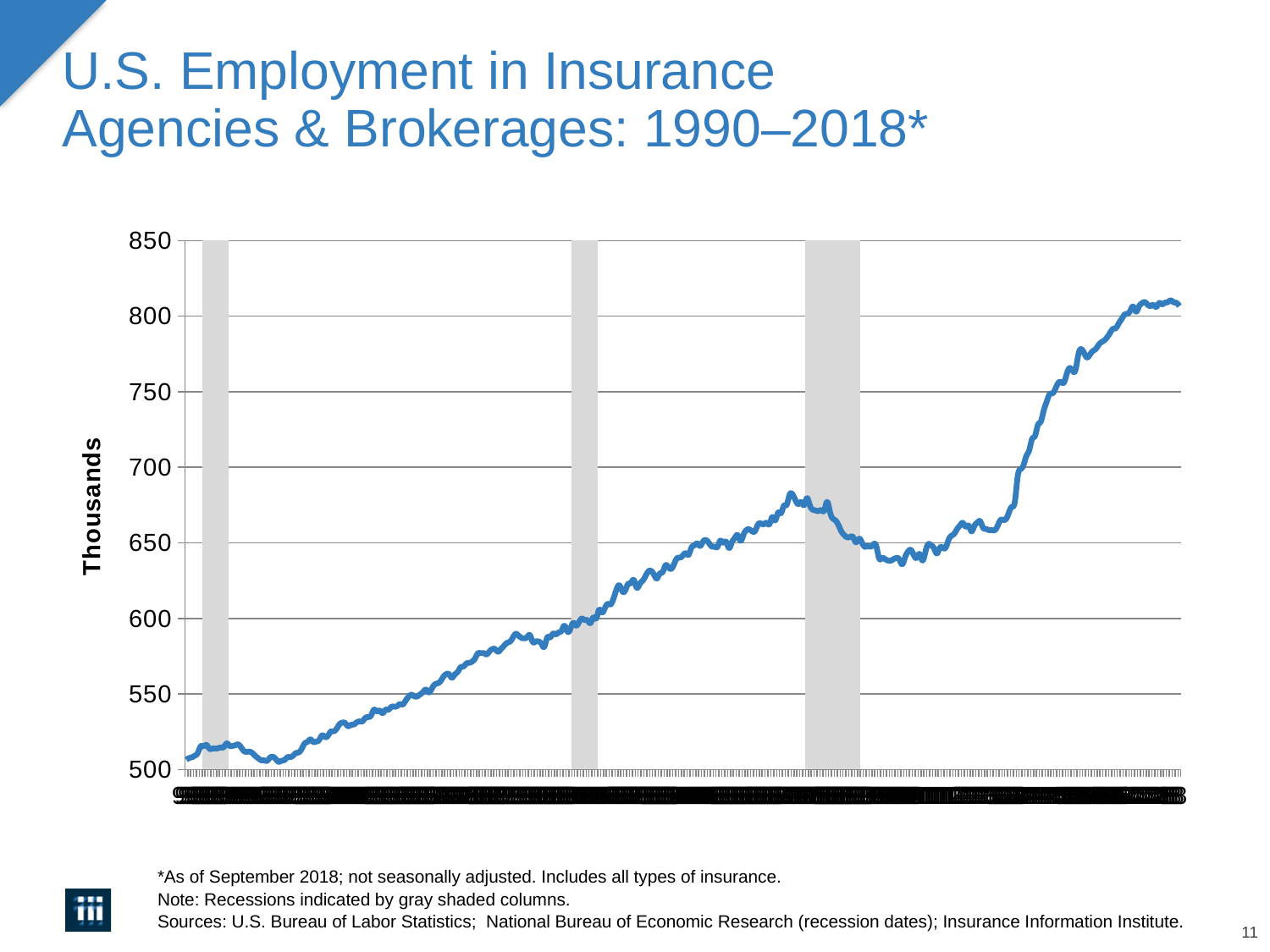
Is the peak reached just before the third gray recession column greater or less than 700? less What is the highest tick value shown on the vertical axis? 850 Is the value at the end of the series greater or less than the value at the start of the series? greater Overall, does employment rise or fall from the start of the series to the end? rise What is the label on the vertical axis of the chart? Thousands Is the lowest point of the series greater or less than 550? less What is the title of the chart on the slide? U.S. Employment in Insurance Agencies & Brokerages: 1990–2018* What kind of chart is shown on the slide? line chart Is the value at the end of the series (2018) greater or less than 800? greater